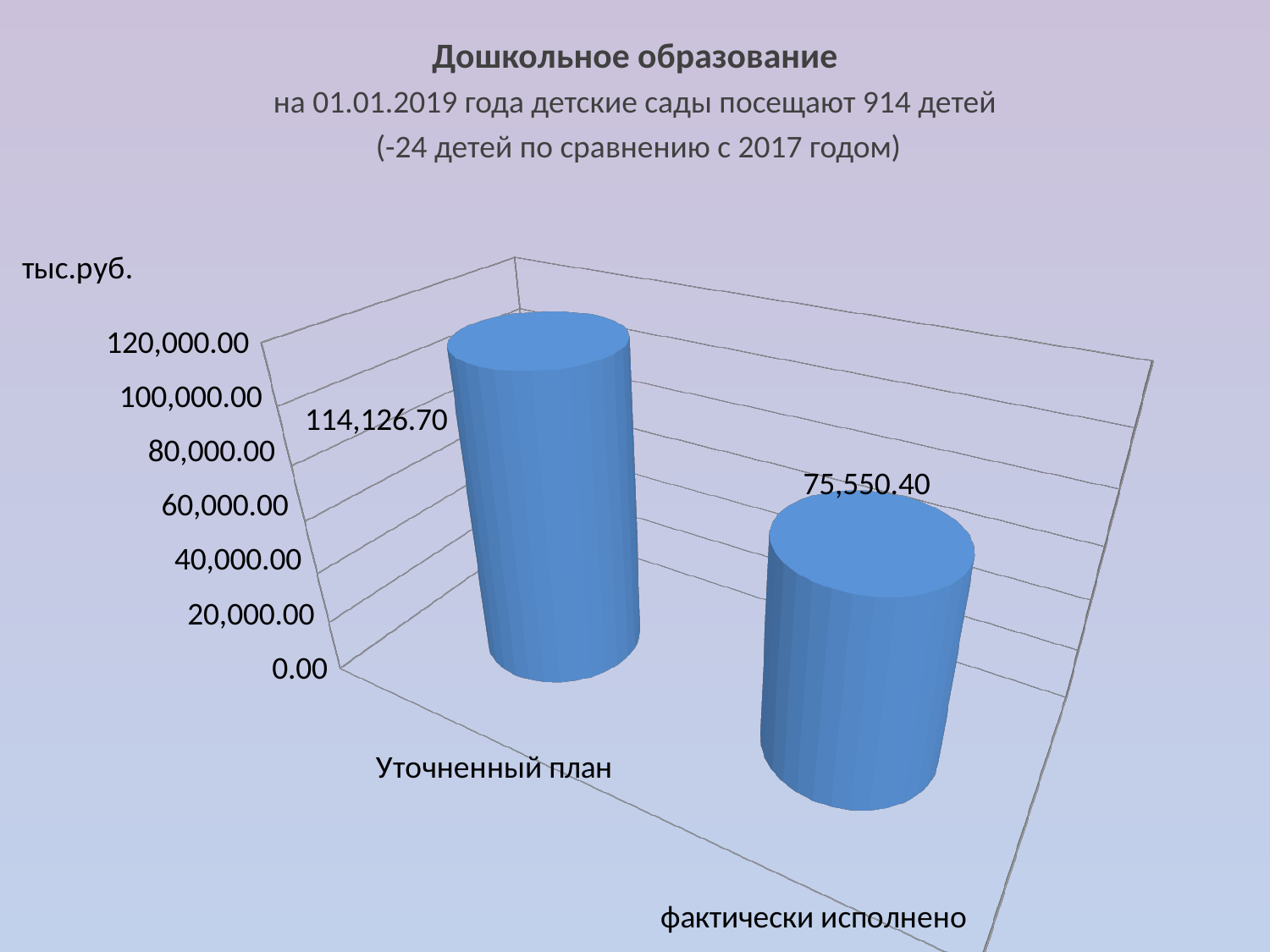
Is the value for фактически исполнено greater or less than 80,000.00? less How many categories are shown in the chart? 2 What is the highest value shown on the vertical axis? 120,000.00 Which is larger, the value for Уточненный план or the value for фактически исполнено? Уточненный план Which category has the lowest value? фактически исполнено Which category has the highest value? Уточненный план What kind of chart is shown on the slide? bar chart What is the difference between the value for Уточненный план and the value for фактически исполнено? 38,576.30 What is the value for фактически исполнено? 75,550.40 Is the value for Уточненный план greater or less than 100,000.00? greater What is the value for Уточненный план? 114,126.70 What unit is shown for the values on the chart? тыс.руб.